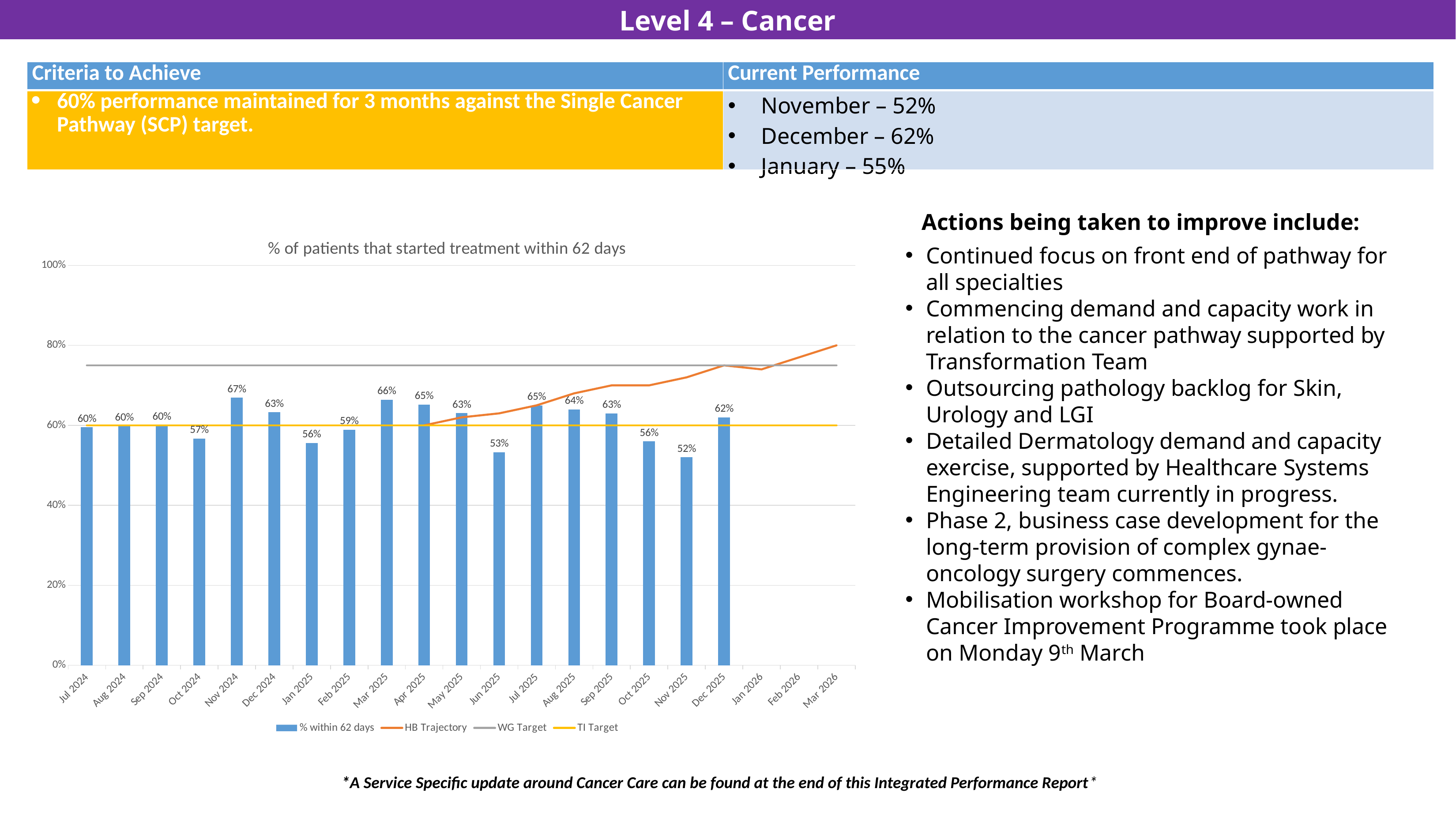
What kind of chart is shown on the slide? combination bar and line chart Which is larger, the value for Jun 2025 or the value for Oct 2025? Oct 2025 What is the value for Mar 2025 in the chart? 66% How many months have a bar plotted in the chart? 18 Is the value for Jun 2025 greater or less than 60%? less What is the value for Dec 2025 in the chart? 62% Which month has the highest bar in the chart? Nov 2024 Which month has the lowest bar in the chart? Nov 2025 What is the title of the chart? % of patients that started treatment within 62 days What is the difference between the values for Nov 2024 and Nov 2025? 15 percentage points What is the value for Nov 2025 in the '% of patients that started treatment within 62 days' chart? 52% How many series does the chart legend list? 4